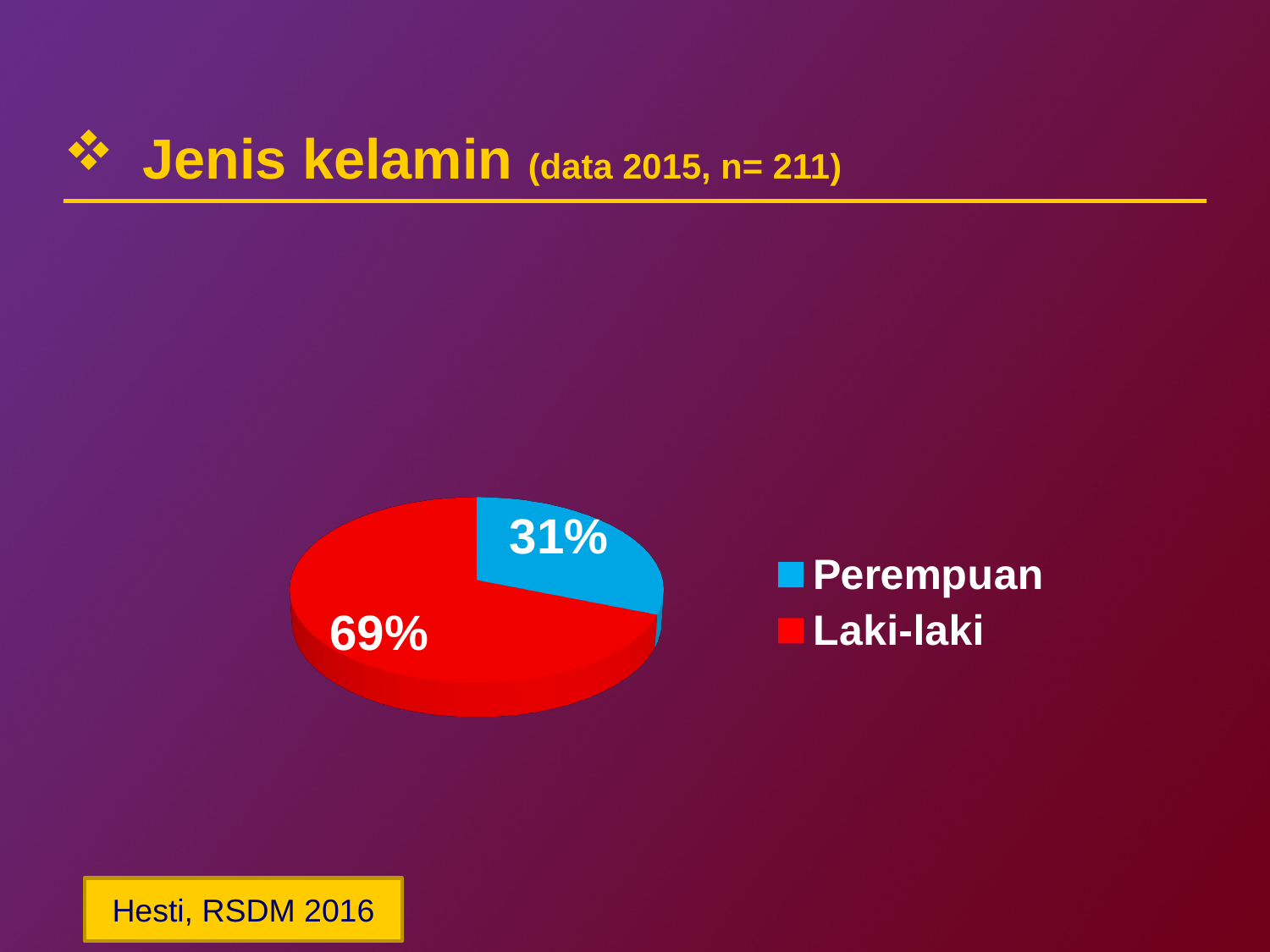
Which category has the smallest slice of the pie? Perempuan What is the difference in percentage points between the Laki-laki and Perempuan slices? 38 What kind of chart is shown on the slide? Pie chart What colour is the Perempuan slice? Blue How many categories does the pie chart show? 2 Which slice is larger, Perempuan or Laki-laki? Laki-laki Which category has the largest slice of the pie? Laki-laki What colour is the Laki-laki slice? Red What share of the pie does Laki-laki represent? 69% What share of the pie does Perempuan represent? 31% How many entries does the legend list? 2